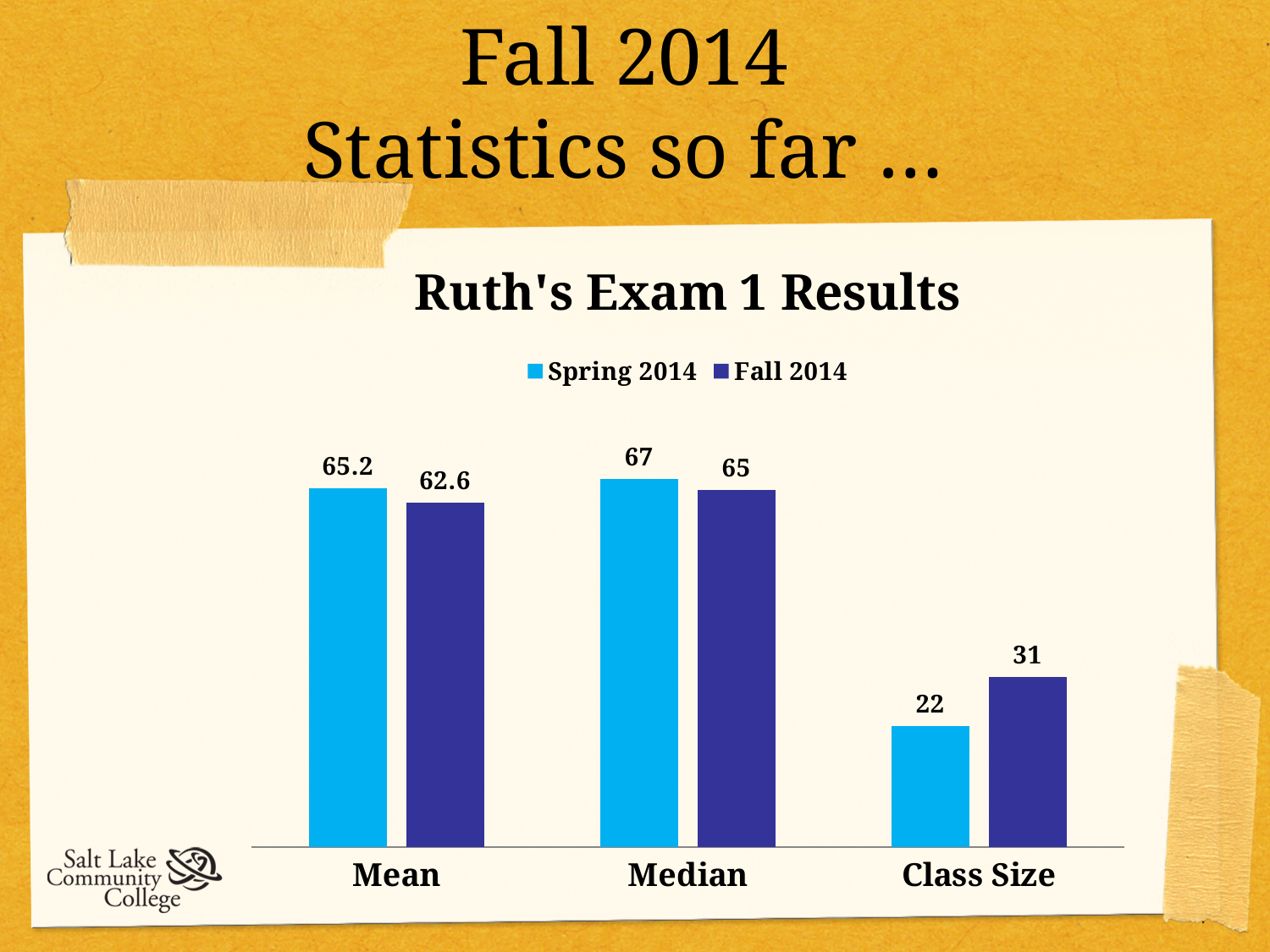
What is the Spring 2014 value for Mean? 65.2 What kind of chart is shown? Bar chart Which is larger for Median: Spring 2014 or Fall 2014? Spring 2014 Which category has the highest Spring 2014 value? Median What is the title of the chart? Ruth's Exam 1 Results What is the Fall 2014 value for Class Size? 31 Which category has the lowest Fall 2014 value? Class Size How many categories are shown on the x axis? 3 What is the Fall 2014 value for Median? 65 What is the difference between the Spring 2014 and Fall 2014 values for Mean? 2.6 What is the difference between the Fall 2014 and Spring 2014 values for Class Size? 9 How many series does the legend list? 2